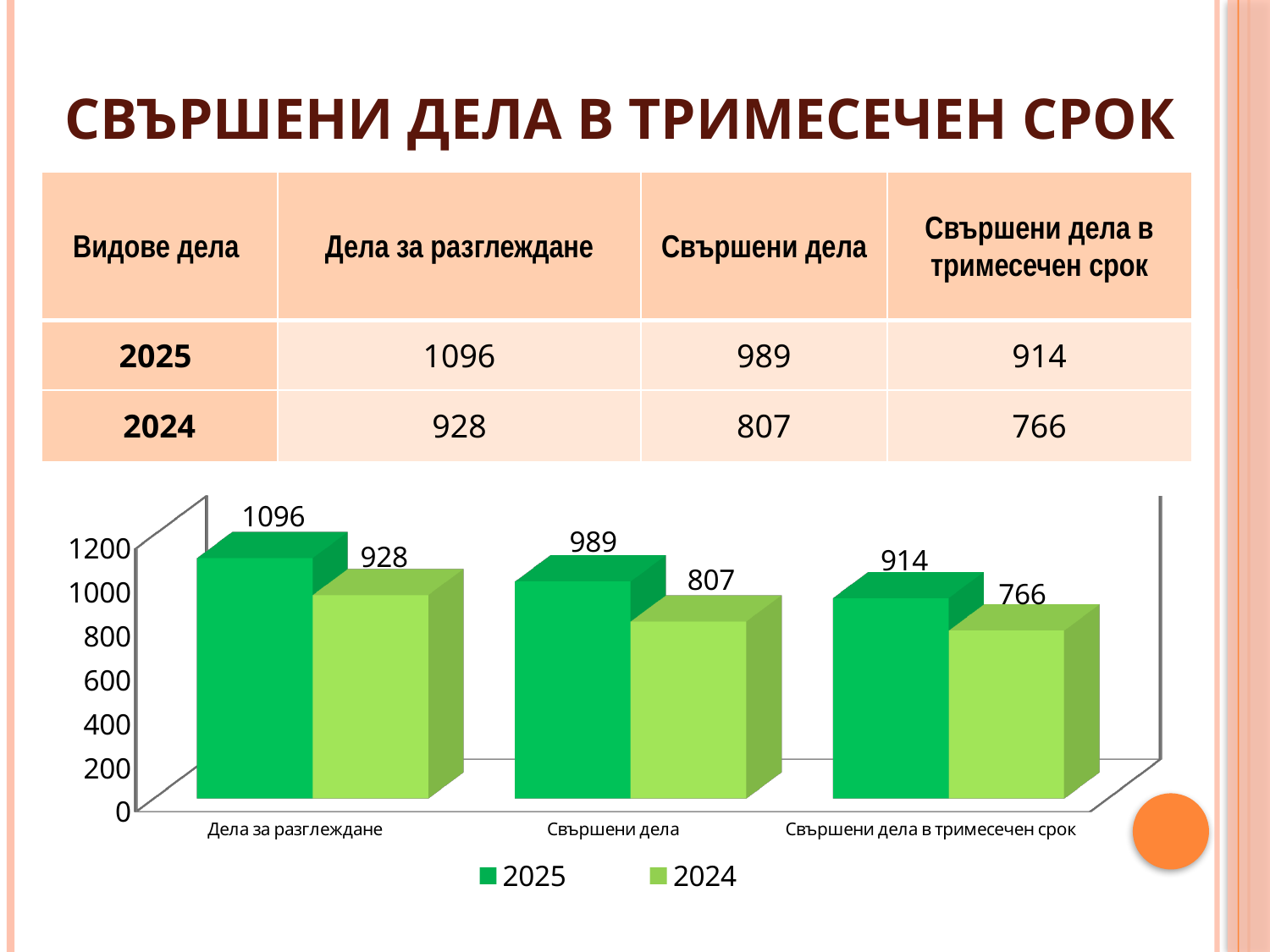
What kind of chart is shown on the slide? Bar chart Do the values for the 2025 series rise or fall from left to right along the x axis? Fall Which category has the lowest value for the 2024 series? Свършени дела в тримесечен срок What is the value for 2025 in the 'Дела за разглеждане' category? 1096 How many categories are shown on the x axis of the chart? 3 Which is larger: the 2025 value for 'Свършени дела' or the 2024 value for 'Дела за разглеждане'? 2025 value for 'Свършени дела' What is the difference between the 2025 and 2024 values for 'Дела за разглеждане'? 168 What is the value for 2024 in the 'Свършени дела' category? 807 What is the difference between the 2025 and 2024 values for 'Свършени дела в тримесечен срок'? 148 How many series does the legend list? 2 Which category has the highest value for the 2025 series? Дела за разглеждане What is the value for 2024 in the 'Свършени дела в тримесечен срок' category? 766